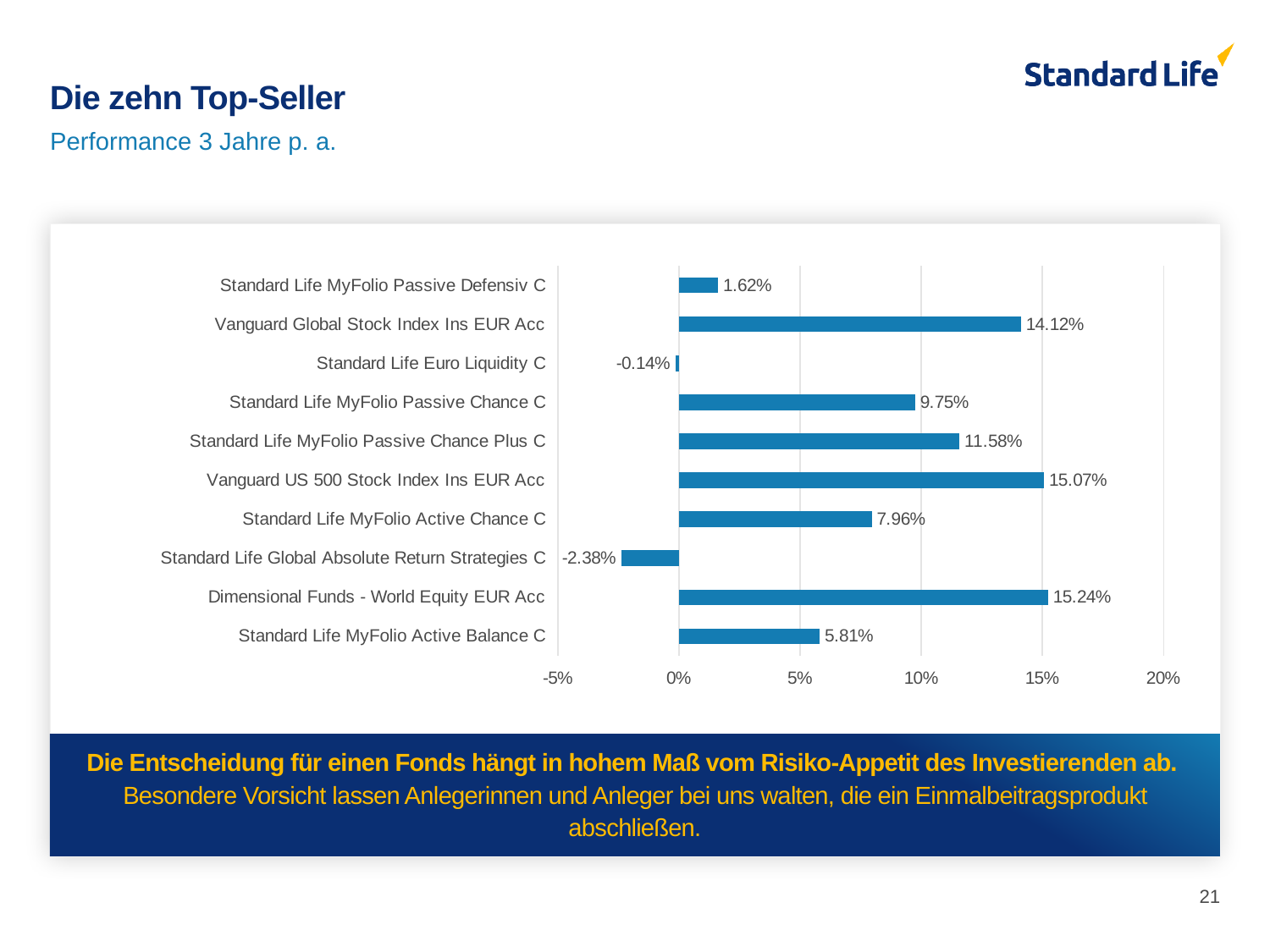
How many funds are shown in the chart? 10 What is the difference between the values for Vanguard Global Stock Index Ins EUR Acc and Standard Life MyFolio Passive Chance C? 4.37 percentage points What is the 3-year performance p.a. shown for Vanguard US 500 Stock Index Ins EUR Acc? 15.07% What is the value for Standard Life MyFolio Active Balance C? 5.81% What value is shown for Standard Life Euro Liquidity C? -0.14% Which has the larger value: Vanguard Global Stock Index Ins EUR Acc or Standard Life MyFolio Passive Chance Plus C? Vanguard Global Stock Index Ins EUR Acc What kind of chart is shown on the slide? Bar chart Is the value for Standard Life MyFolio Passive Chance C greater or less than 5%? greater Which fund has the lowest value in the chart? Standard Life Global Absolute Return Strategies C How many funds in the chart have a negative value? 2 Which fund has the highest value in the chart? Dimensional Funds - World Equity EUR Acc What is the difference between the values for Standard Life MyFolio Passive Chance Plus C and Standard Life MyFolio Active Chance C? 3.62 percentage points